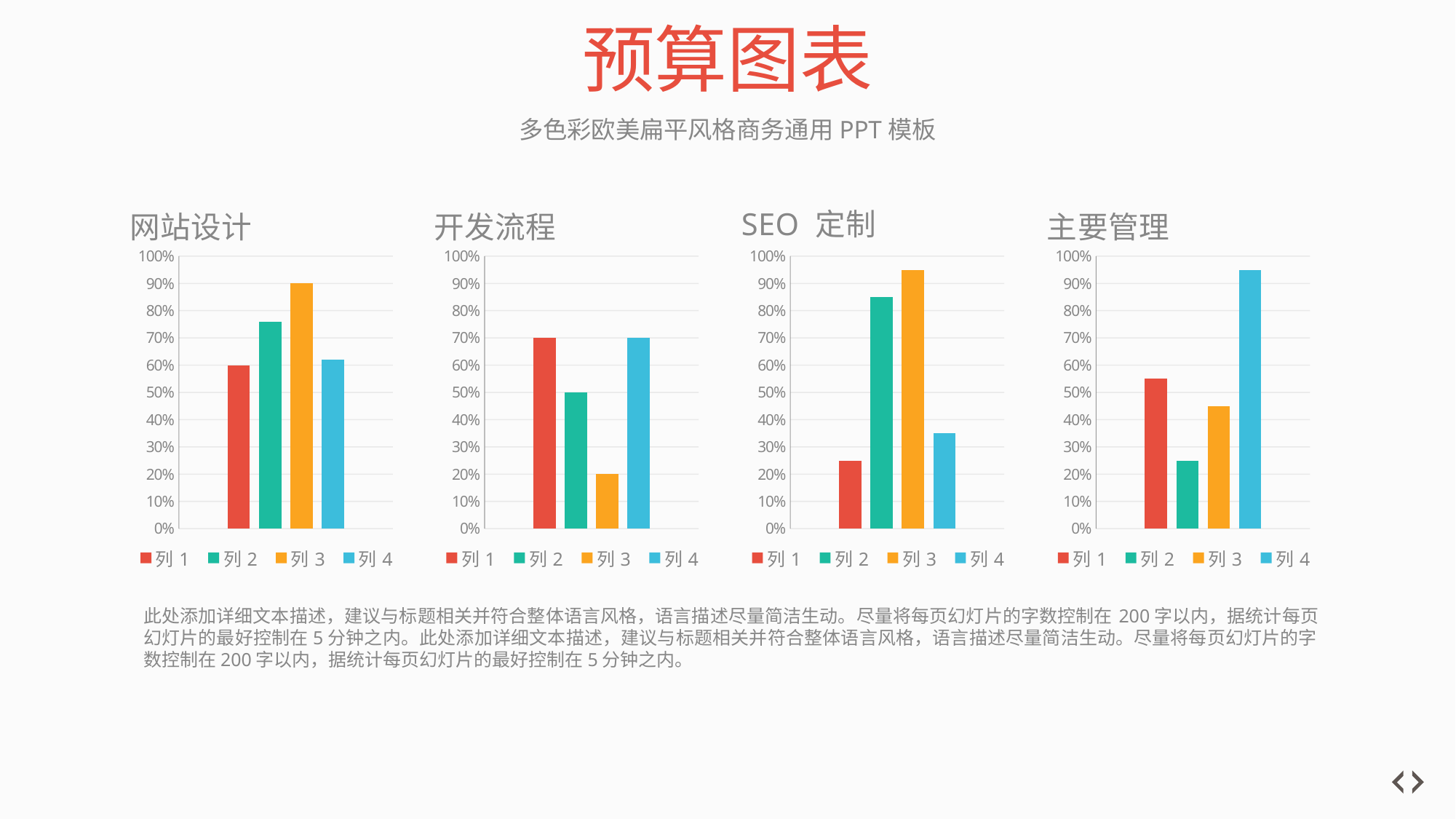
In the 网站设计 chart, what is the value for 列 3? 90% In the 网站设计 chart, what is the value for 列 1? 60% In the 开发流程 chart, what is the difference between 列 1 and 列 3? 50% In the SEO 定制 chart, which series has the highest bar? 列 3 In the 开发流程 chart, what is the value for 列 2? 50% In the 开发流程 chart, which series has the lowest bar? 列 3 In the 网站设计 chart, which series has the highest bar? 列 3 In the 网站设计 chart, is the value for 列 2 greater or less than 70%? greater In the 主要管理 chart, which series has the lowest bar? 列 2 In the SEO 定制 chart, is the value for 列 2 greater or less than 80%? greater In the 开发流程 chart, what is the value for 列 3? 20% How many series does the legend of the 主要管理 chart list? 4